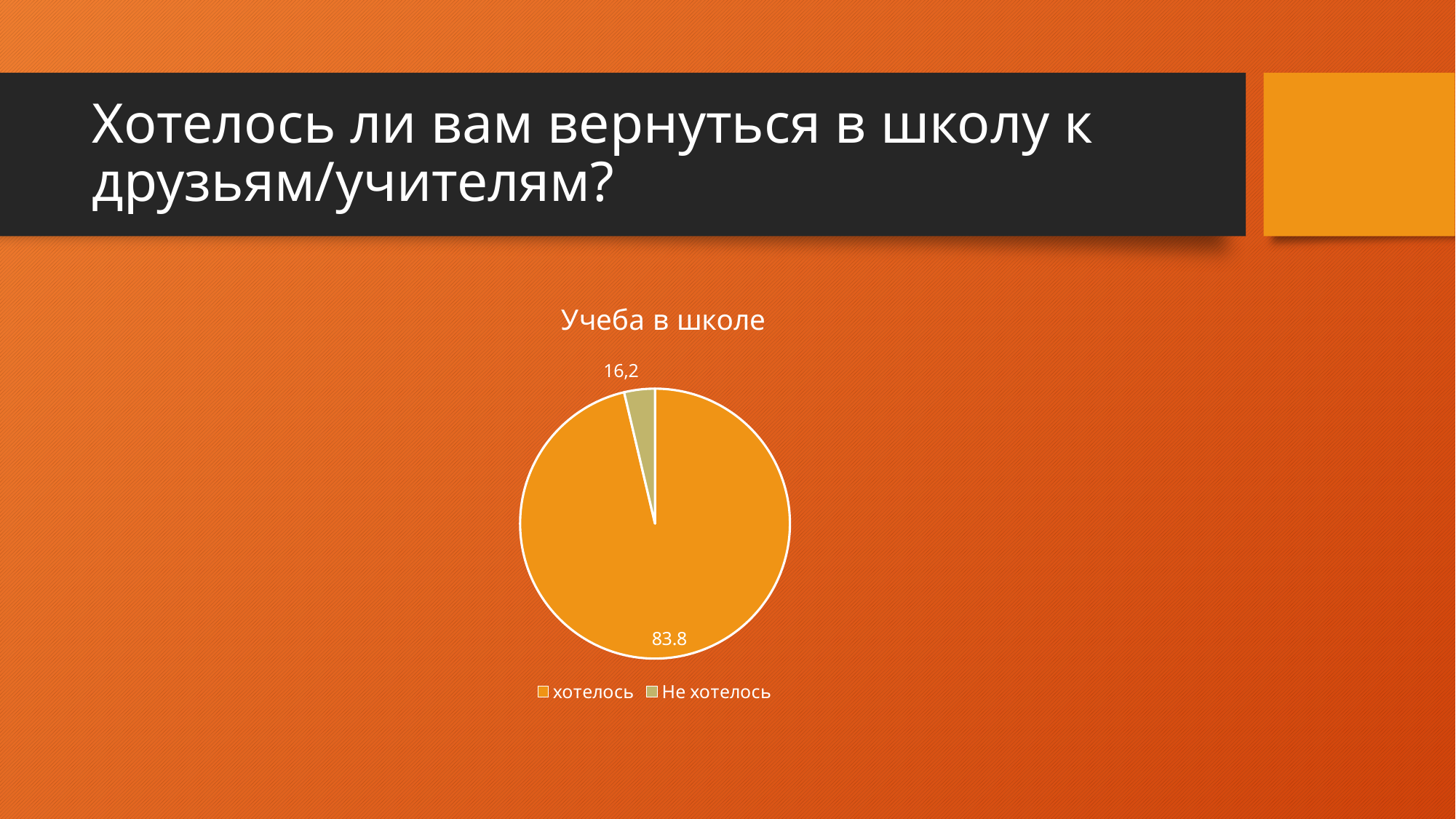
What is the title of the chart? Учеба в школе What colour is the "хотелось" slice in the pie chart? orange How many entries does the legend list? 2 What value is shown for the "Не хотелось" slice? 16,2 What value is shown for the "хотелось" slice? 83.8 What kind of chart is shown on the slide? pie chart Which is larger, the value for "хотелось" or the value for "Не хотелось"? хотелось Which slice of the pie is the largest? хотелось Which slice of the pie is the smallest? Не хотелось How many slices does the pie chart have? 2 What is the difference between the value for "хотелось" and the value for "Не хотелось"? 67.6